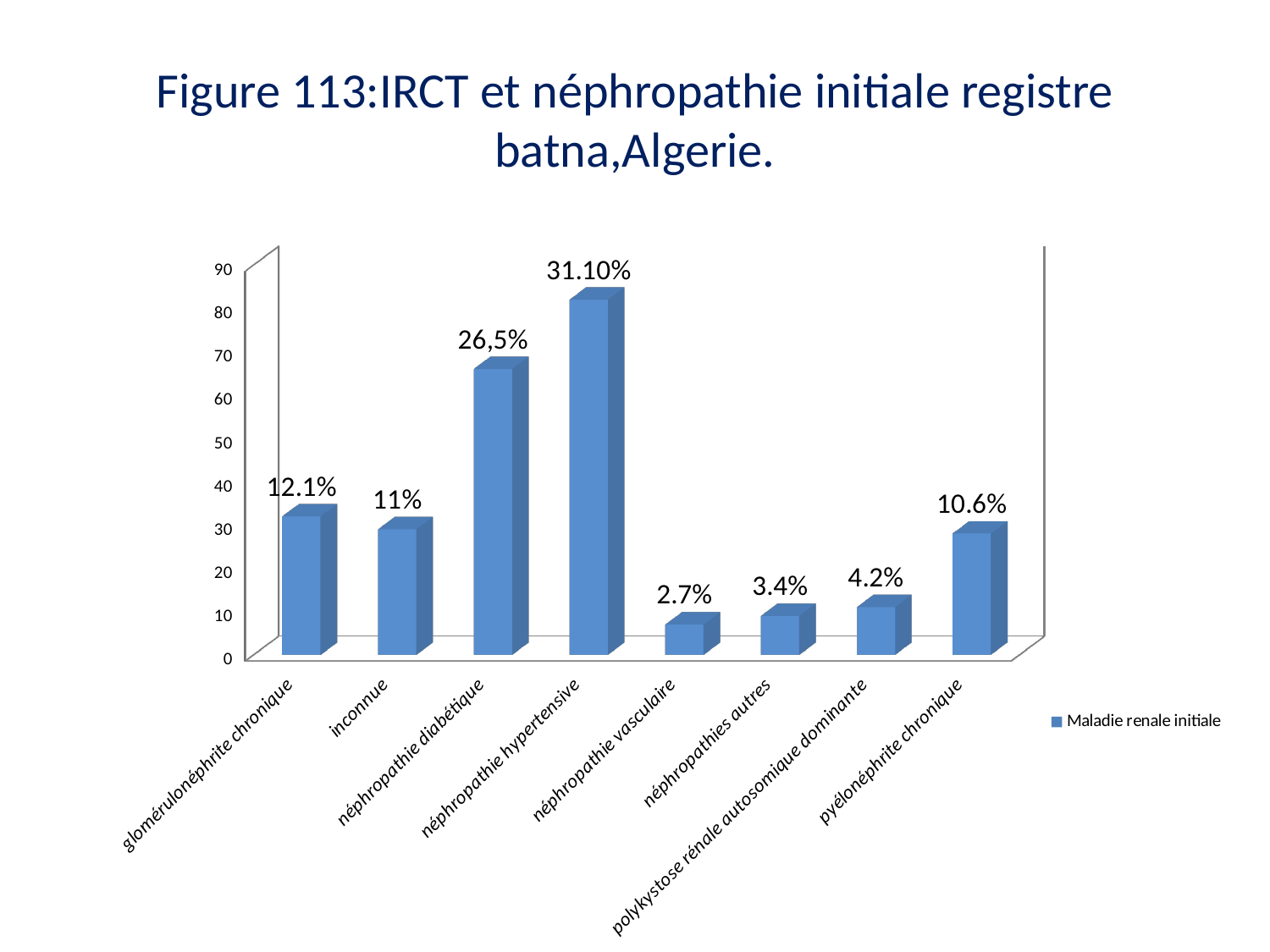
What kind of chart is shown on the slide? bar chart What value is shown for polykystose rénale autosomique dominante? 4.2% How many categories are shown on the x axis? 8 Which is larger, the value for inconnue or the value for néphropathies autres? inconnue Which category has the lowest value? néphropathie vasculaire Which category has the highest value? néphropathie hypertensive What value is shown for néphropathie hypertensive? 31.10% What is the difference between the values for polykystose rénale autosomique dominante and néphropathie vasculaire? 1.5% What value is shown for pyélonéphrite chronique? 10.6% What value is shown for néphropathie diabétique? 26,5% What is the difference between the values for glomérulonéphrite chronique and pyélonéphrite chronique? 1.5% What series name does the legend list? Maladie renale initiale